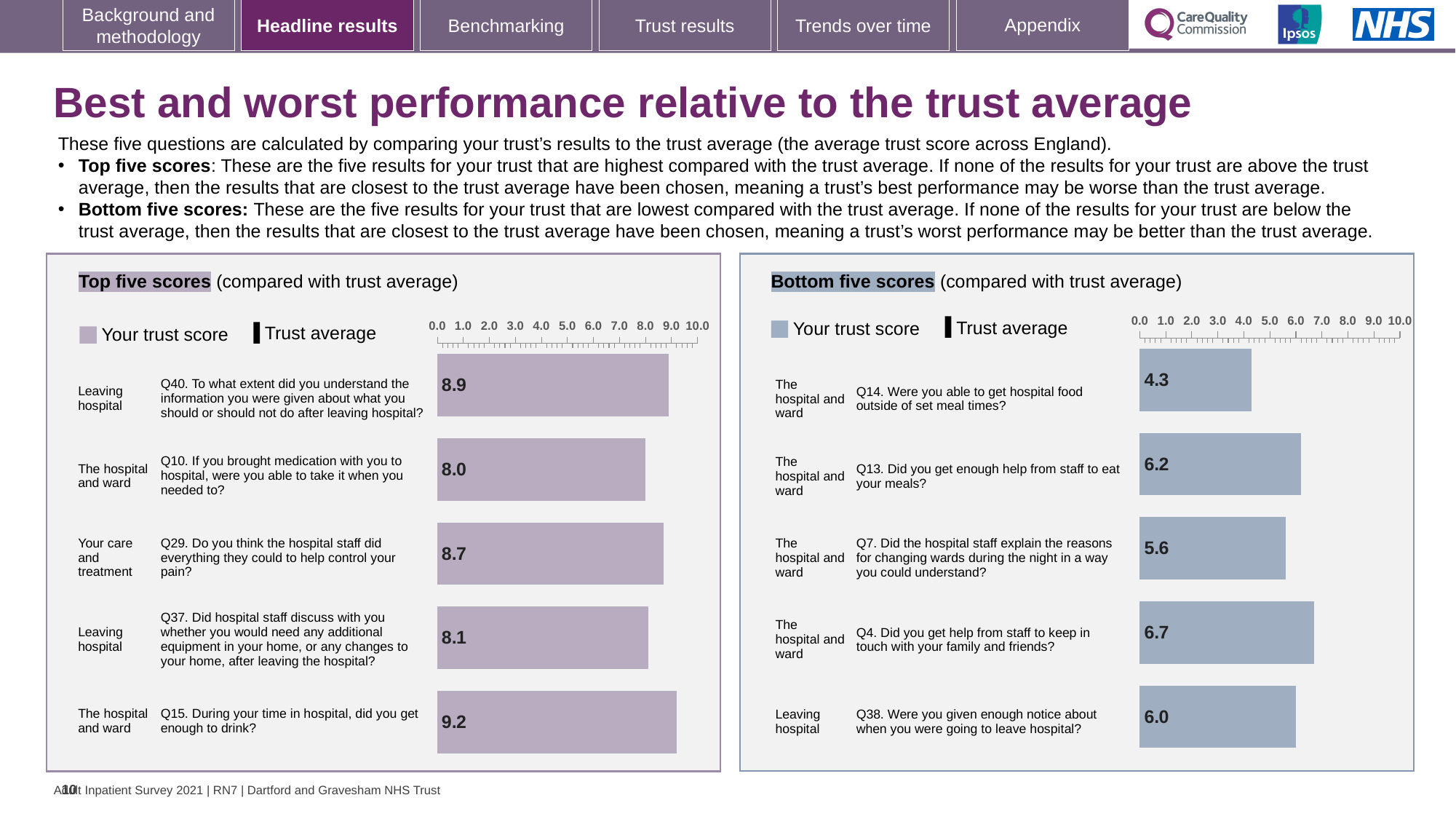
In the Top five scores chart, which question has the highest trust score? Q15 In the Top five scores chart, what is the trust score for Q15 (During your time in hospital, did you get enough to drink?)? 9.2 In the Top five scores chart, what is the difference between the scores for Q15 and Q10? 1.2 In the Bottom five scores chart, which has the larger score, Q13 or Q4? Q4 In the Bottom five scores chart, is the value for Q7 greater or less than 6.0? less What type of chart is used in the Top five scores panel? Bar chart In the Bottom five scores chart, which question has the lowest trust score? Q14 How many bars are shown in the Top five scores chart? 5 In the Bottom five scores chart, what is the difference between the scores for Q4 and Q14? 2.4 What two entries does the legend of the Bottom five scores chart list? Your trust score; Trust average In the Bottom five scores chart, which question has the highest trust score? Q4 In the Bottom five scores chart, what is the trust score for Q14 (Were you able to get hospital food outside of set meal times?)? 4.3